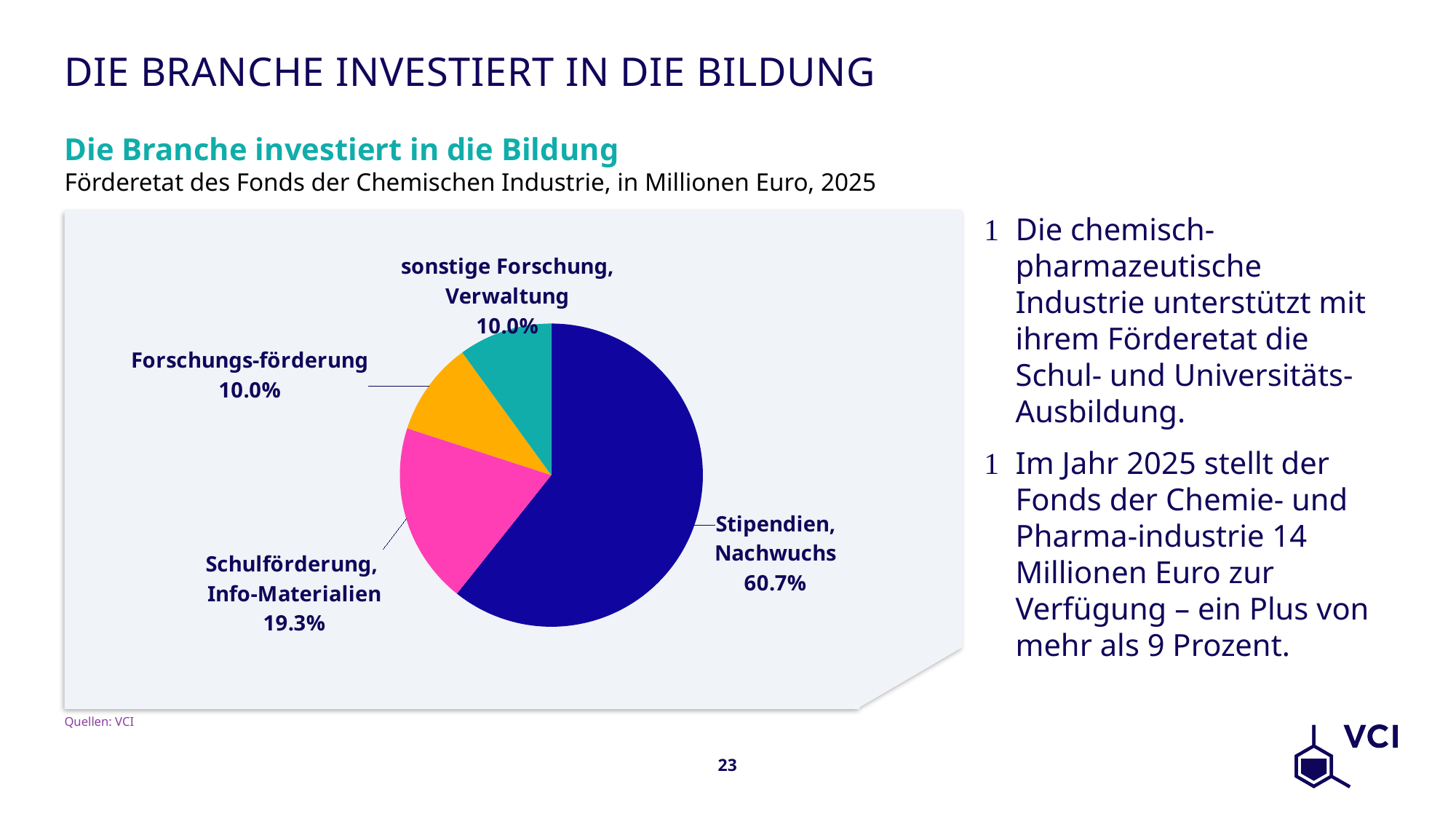
What is the difference in percentage points between Stipendien, Nachwuchs and Schulförderung, Info-Materialien? 41.4 What is the combined share of Forschungs-förderung and sonstige Forschung, Verwaltung? 20.0% What kind of chart is shown on the slide? Pie chart Which is larger: the share for Schulförderung, Info-Materialien or the share for Forschungs-förderung? Schulförderung, Info-Materialien What share of the pie does Schulförderung, Info-Materialien have? 19.3% Which category has the largest share of the pie? Stipendien, Nachwuchs What is the title of the chart? Die Branche investiert in die Bildung What share of the pie does sonstige Forschung, Verwaltung have? 10.0% How many slices does the pie chart have? 4 What colour is the Stipendien, Nachwuchs slice? Dark blue What share of the pie does Forschungs-förderung have? 10.0% What share of the pie does Stipendien, Nachwuchs have? 60.7%